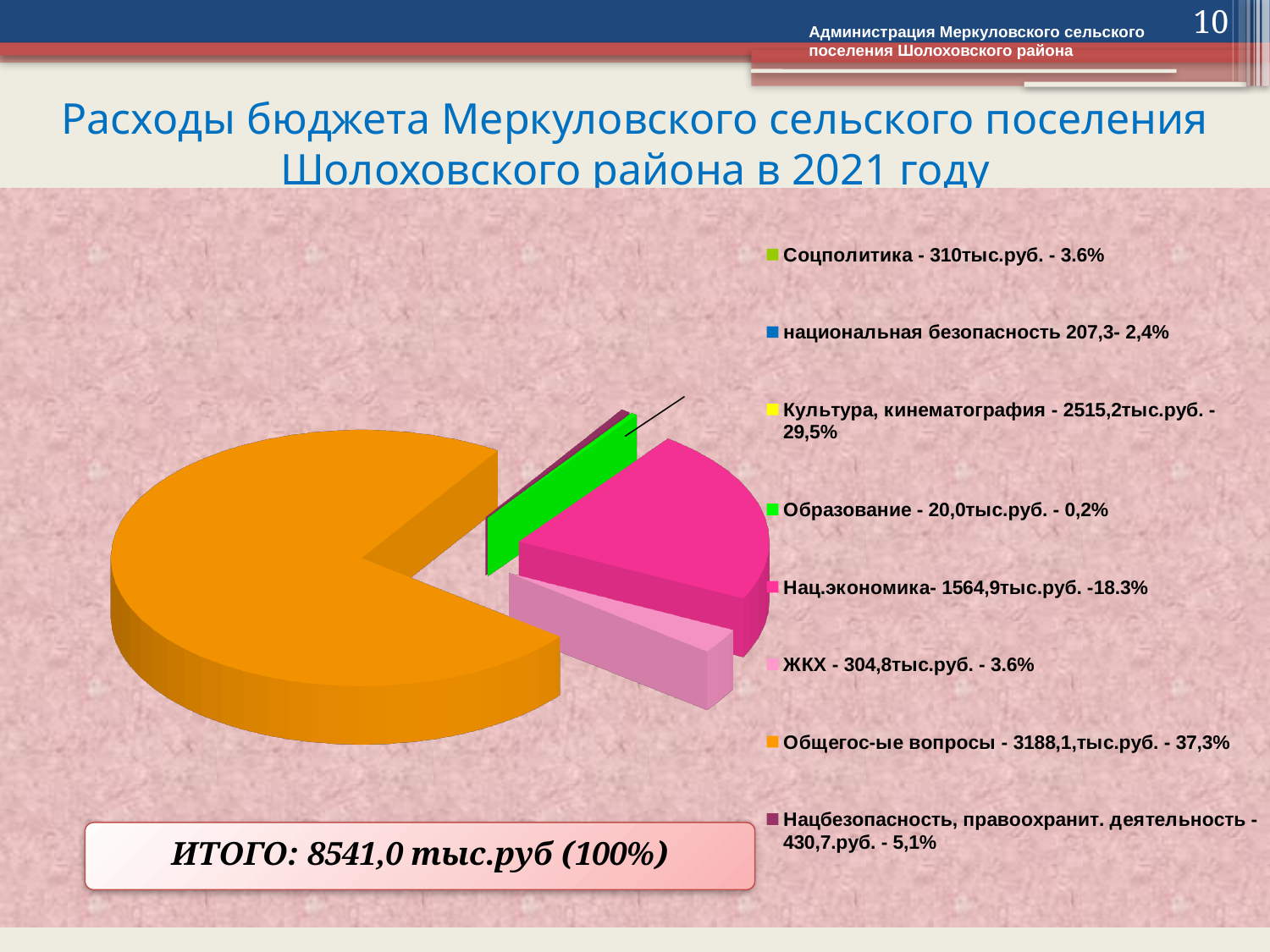
What is the amount for Нац.экономика? 1564,9тыс.руб. Which is larger: the amount for Культура, кинематография or for Нац.экономика? Культура, кинематография How many categories does the legend of the pie chart list? 8 What share of the budget expenses goes to Нацбезопасность, правоохранит. деятельность? 5,1% What kind of chart is shown on the slide? Pie chart What is the difference in percentage points between the share of Общегос-ые вопросы and the share of Культура, кинематография? 7,8 What is the total of the budget expenses shown on the slide? 8541,0 тыс.руб Which category has the largest share of the budget expenses? Общегос-ые вопросы What is the title of the slide? Расходы бюджета Меркуловского сельского поселения Шолоховского района в 2021 году What share of the budget expenses goes to Культура, кинематография? 29,5% What is the amount for Образование? 20,0тыс.руб. Which category has the smallest share of the budget expenses? Образование